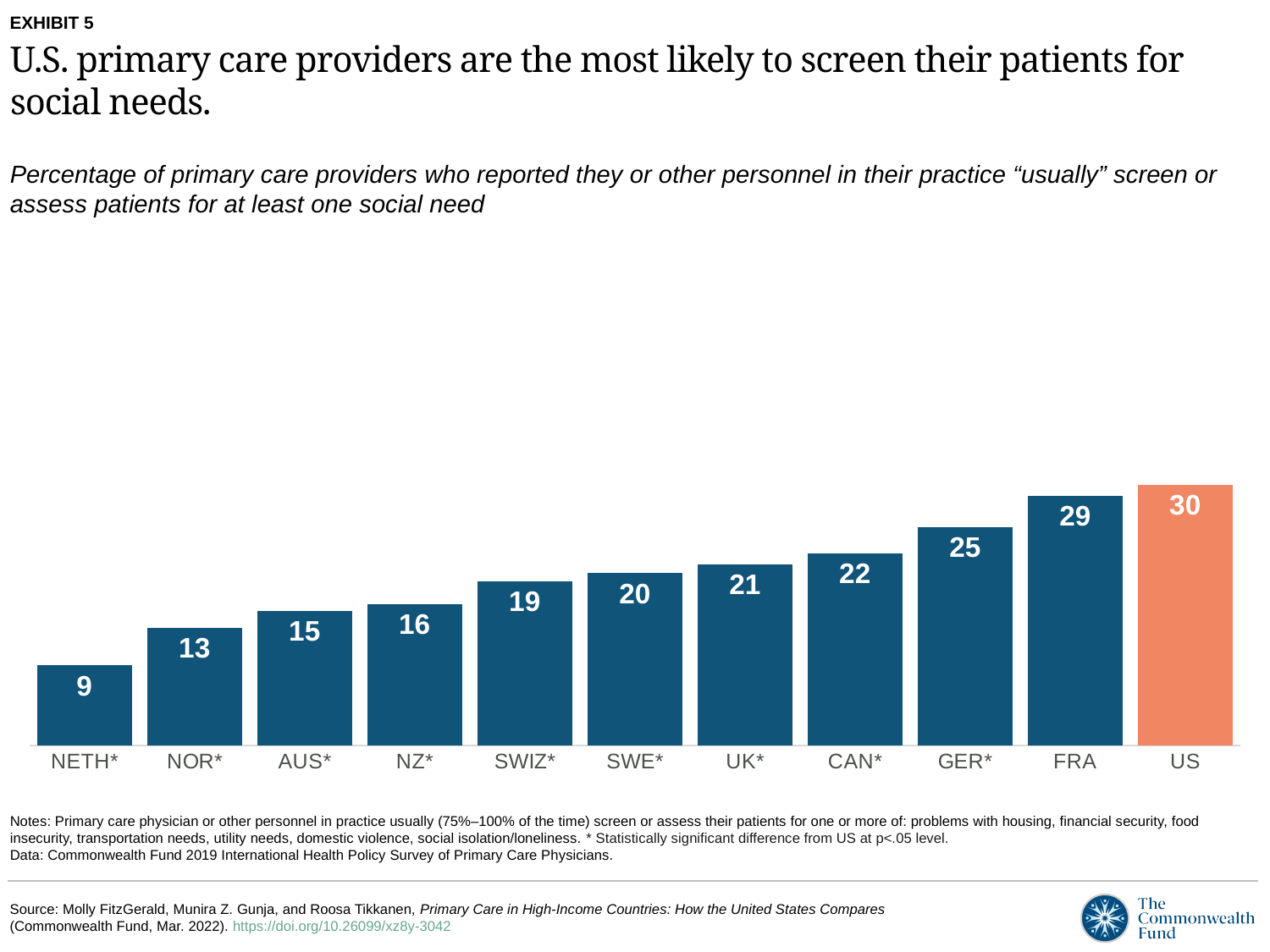
What is the difference between the values for FRA and CAN*? 7 What kind of chart is shown on the slide? Bar chart What is the value for GER*? 25 Which country has the lowest value? NETH* Do the values rise or fall from left to right along the x axis? Rise What is the value for NETH*? 9 What is the value for SWIZ*? 19 What is the value for US? 30 How many countries are shown in the chart? 11 Which country has the highest value? US Which has a larger value, NOR* or AUS*? AUS* What is the difference between the values for US and NETH*? 21